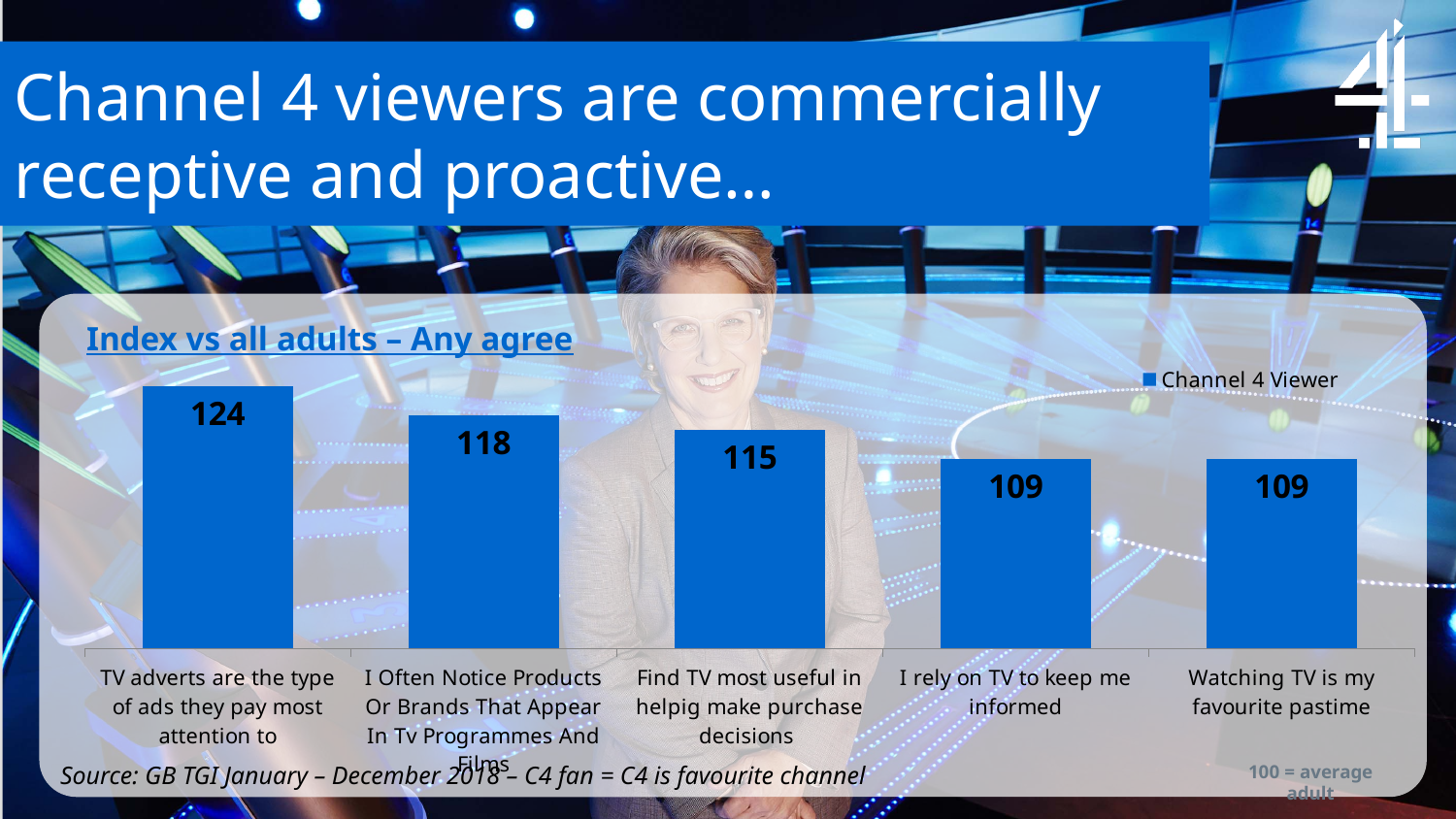
What is the index value for "I rely on TV to keep me informed"? 109 What is the title of the chart? Index vs all adults – Any agree What is the lowest index value shown on the chart? 109 What is the difference between the index for "TV adverts are the type of ads they pay most attention to" and "I Often Notice Products Or Brands That Appear In Tv Programmes And Films"? 6 Which is larger: the index for "I Often Notice Products Or Brands That Appear In Tv Programmes And Films" or for "Find TV most useful in helpig make purchase decisions"? I Often Notice Products Or Brands That Appear In Tv Programmes And Films What is the index value for "Watching TV is my favourite pastime"? 109 How many statements (bars) are shown on the chart? 5 What is the index value for "TV adverts are the type of ads they pay most attention to"? 124 How many series does the legend list? 1 Which statement has the highest index value? TV adverts are the type of ads they pay most attention to What is the index value for "Find TV most useful in helpig make purchase decisions"? 115 What type of chart is shown on the slide? Bar chart